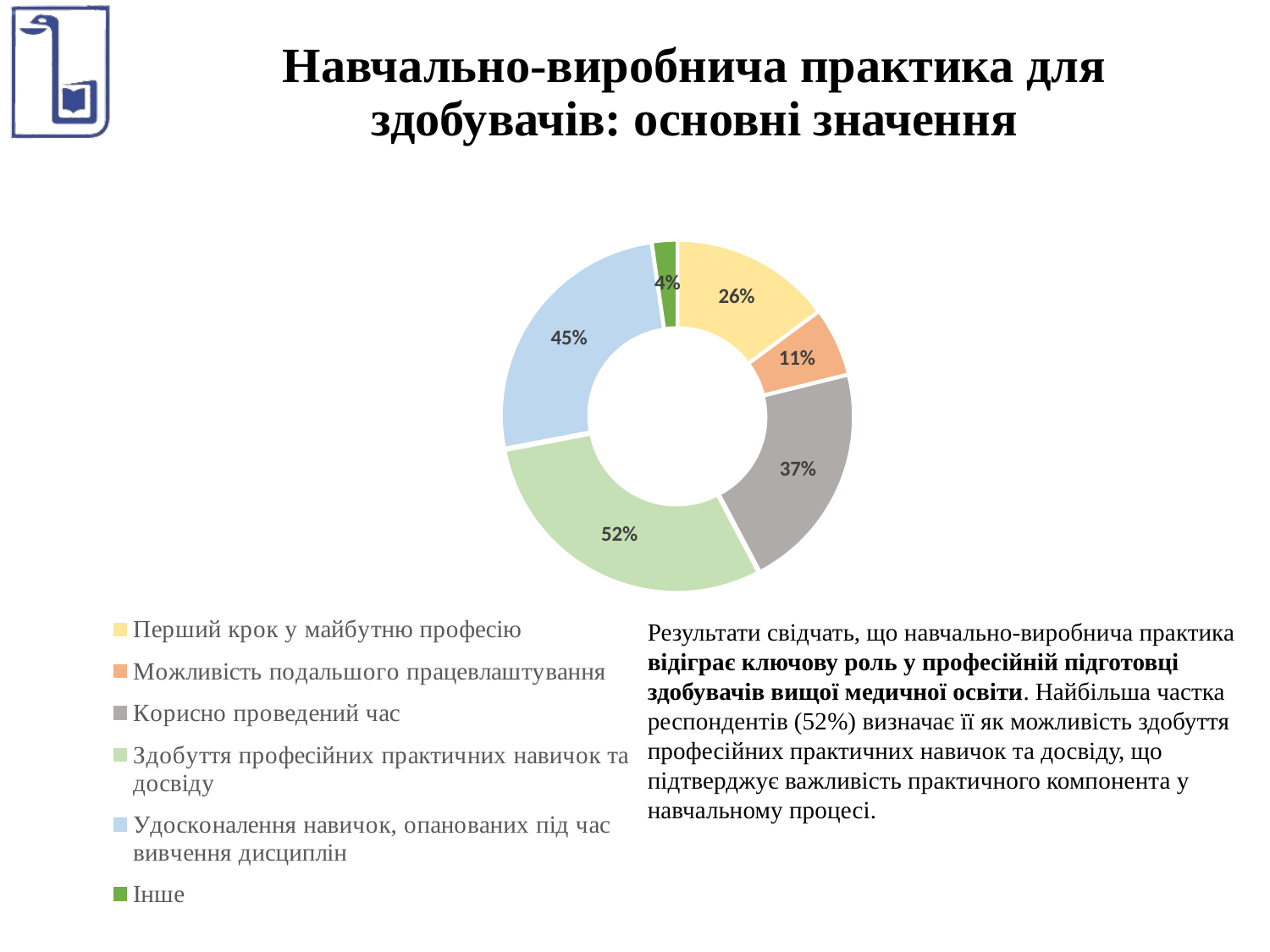
What kind of chart is shown on the slide? Doughnut (pie) chart Which is larger: the share for "Корисно проведений час" or for "Перший крок у майбутню професію"? Корисно проведений час What percentage is shown for "Здобуття професійних практичних навичок та досвіду"? 52% What percentage is shown for "Можливість подальшого працевлаштування"? 11% What percentage is shown for "Перший крок у майбутню професію"? 26% What is the difference between the percentages for "Здобуття професійних практичних навичок та досвіду" and "Удосконалення навичок, опанованих під час вивчення дисциплін"? 7% Which category has the largest share in the chart? Здобуття професійних практичних навичок та досвіду Which category has the smallest share in the chart? Інше What percentage is shown for "Корисно проведений час"? 37% What percentage is shown for "Інше"? 4% What colour is the slice for "Удосконалення навичок, опанованих під час вивчення дисциплін"? Light blue How many categories are shown in the chart? 6